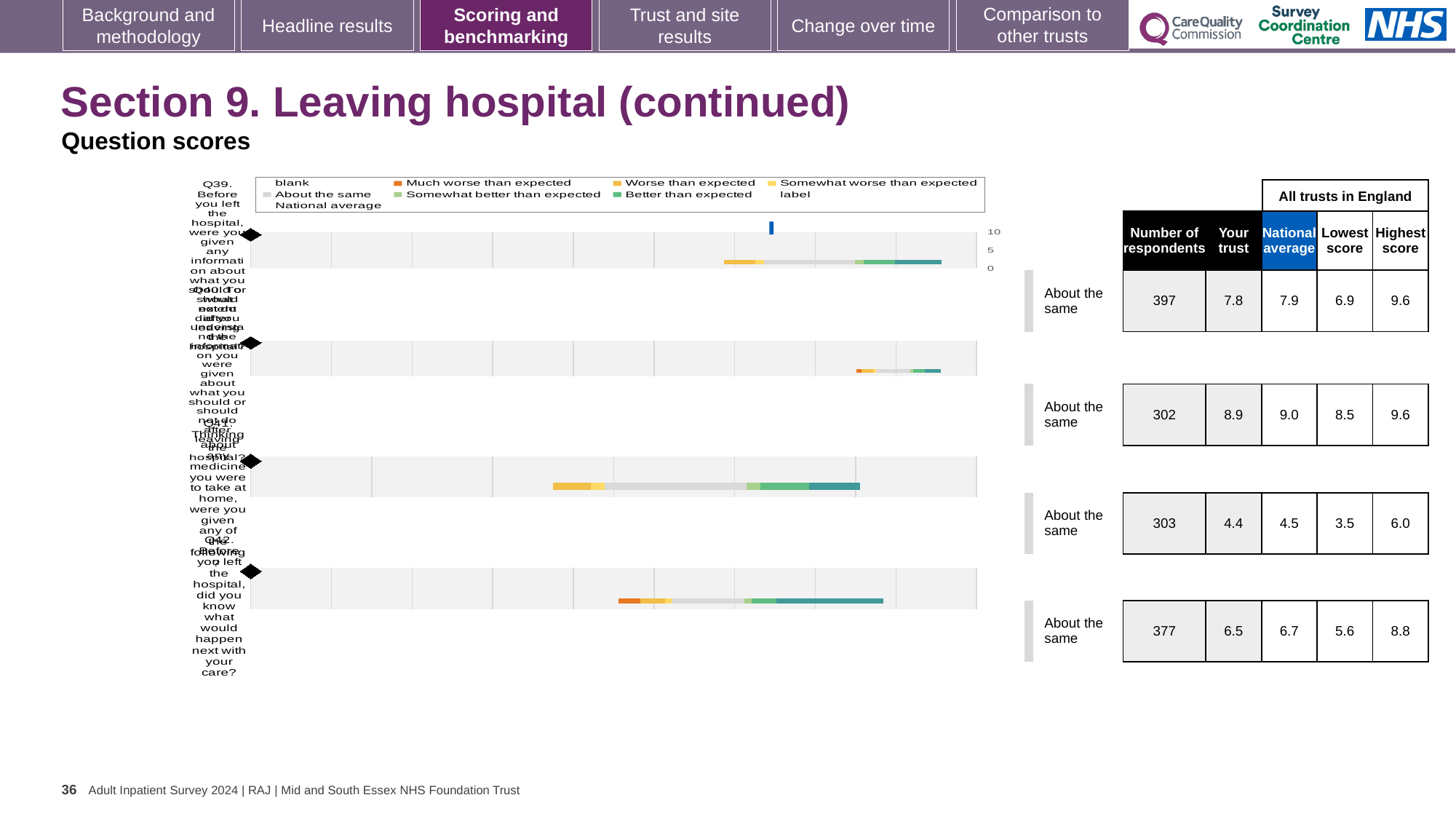
In the table beside the chart, which row has the highest 'Your trust' score? second row (8.9) In the table beside the chart, what is the 'Your trust' score in the first row (Q39)? 7.8 In the table beside the chart, what is the number of respondents in the last row (Q42)? 377 How many question bars are plotted in the chart? 4 In the table beside the chart, what is the national average in the third row? 4.5 In the table beside the chart, is the 'Your trust' score or the 'National average' larger in the last row? National average In the table beside the chart, which row has the lowest 'Your trust' score? third row (4.4) What colour does the legend use for 'Much worse than expected'? orange In the table beside the chart, what is the difference between the highest score and the lowest score in the first row? 2.7 What kind of chart is shown on the slide? bar chart Which question label appears at the top of the chart? Q39 How many entries does the chart's legend list? 9